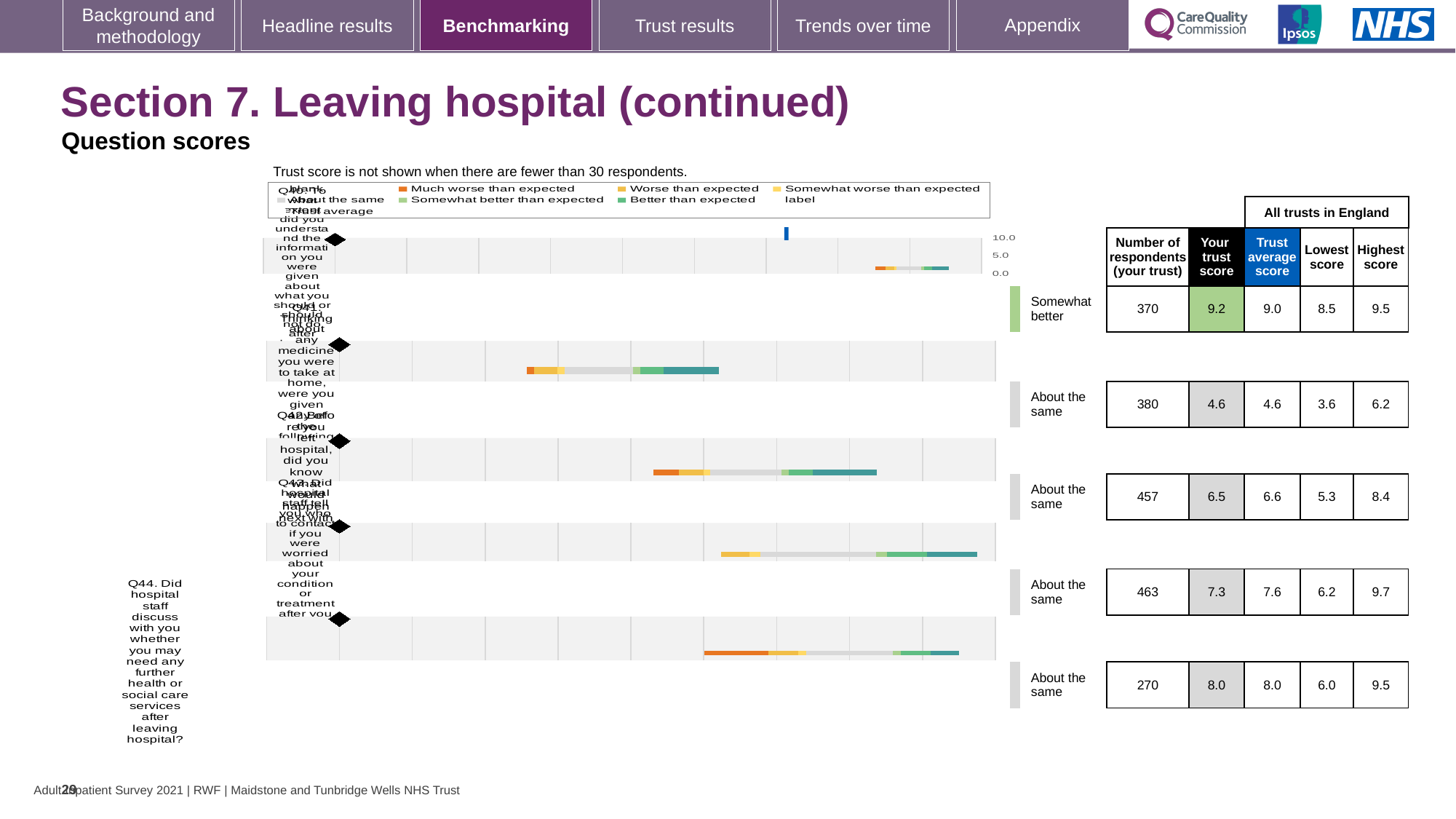
What benchmark category label is shown for the first question row (Q40)? Somewhat better For the fourth question row (Q43), which is larger: 'Your trust score' or 'Trust average score'? Trust average score (7.6) How many question rows are shown in the chart and table? 5 How many question rows are labelled 'About the same'? 4 For the first question row (Q40), what is the difference between 'Your trust score' and 'Trust average score'? 0.2 What kind of chart is used to show the question scores on this slide? bar chart For Q44, what is the difference between the highest score and the lowest score across all trusts in England? 3.5 Which question row has the lowest 'Your trust score' in the table? The second row (Q41), 4.6 What is the 'Your trust score' for Q44 (Did hospital staff discuss with you whether you may need any further health or social care services after leaving hospital?)? 8.0 What is the 'Your trust score' for the first question row (Q40) in the table? 9.2 How many respondents from your trust answered Q44? 270 Which question row has the highest 'Your trust score' in the table? The first row (Q40), 9.2